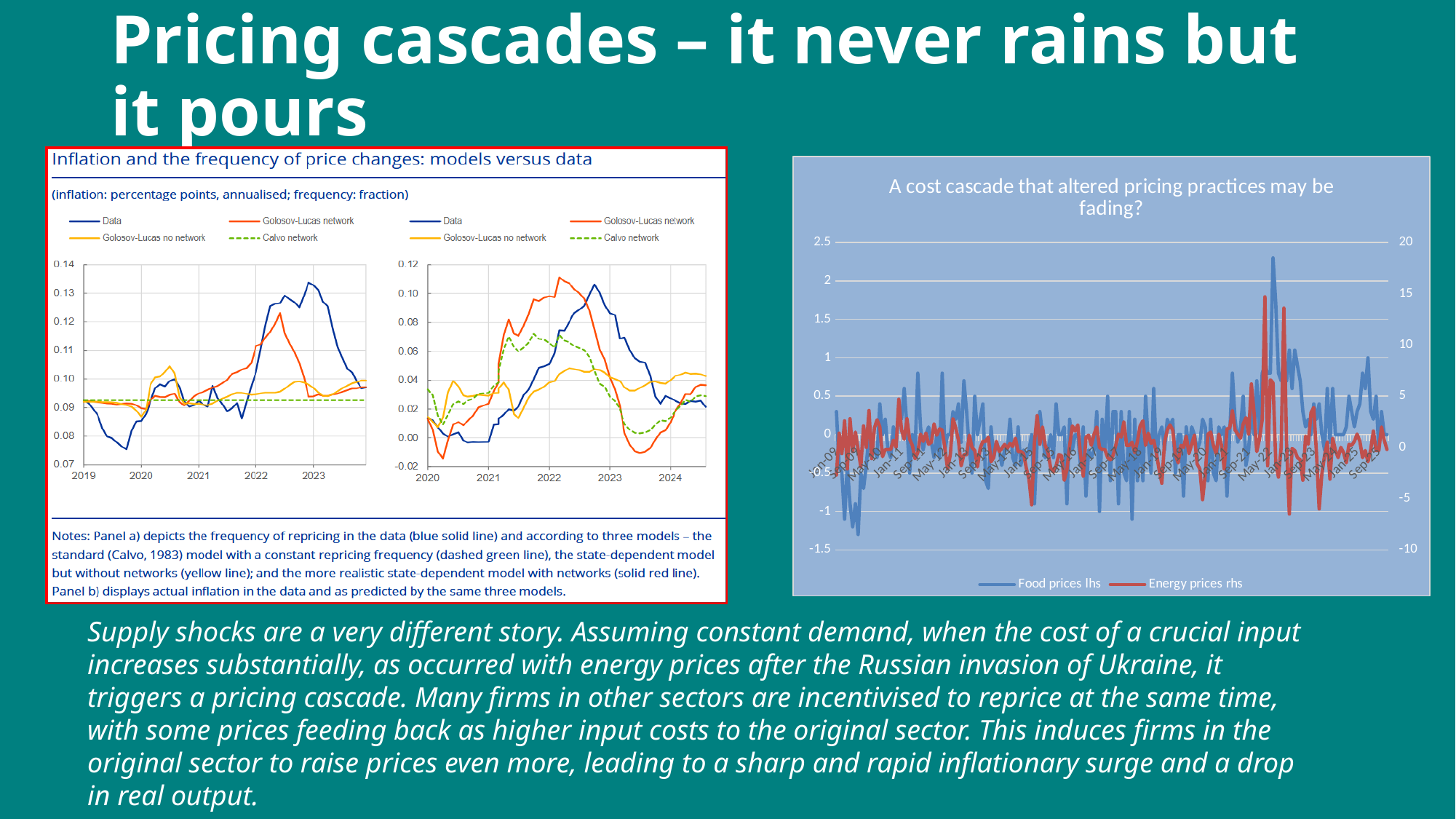
In panel b) of the left-hand chart (x axis 2020 to 2024), is the peak of the Golosov-Lucas network line greater or less than 0.10? greater In the right-hand chart, which series is plotted on the right-hand axis according to the legend? Energy prices rhs What is the title of the left-hand chart? Inflation and the frequency of price changes: models versus data What kind of chart is the right-hand chart titled 'A cost cascade that altered pricing practices may be fading?'? line chart What is the maximum value shown on the left-hand axis of the right-hand chart? 2.5 In the right-hand chart, is the highest peak of the Energy prices series greater or less than 10 on the right axis? greater How many series does the legend of each panel in the left-hand chart list? 4 How many series does the legend of the right-hand chart list? 2 In the right-hand chart, is the highest peak of the Food prices series (around 2022) greater or less than 2 on the left axis? greater In panel a) of the left-hand chart, does the Calvo network line rise, fall, or stay flat across the x axis? stays flat